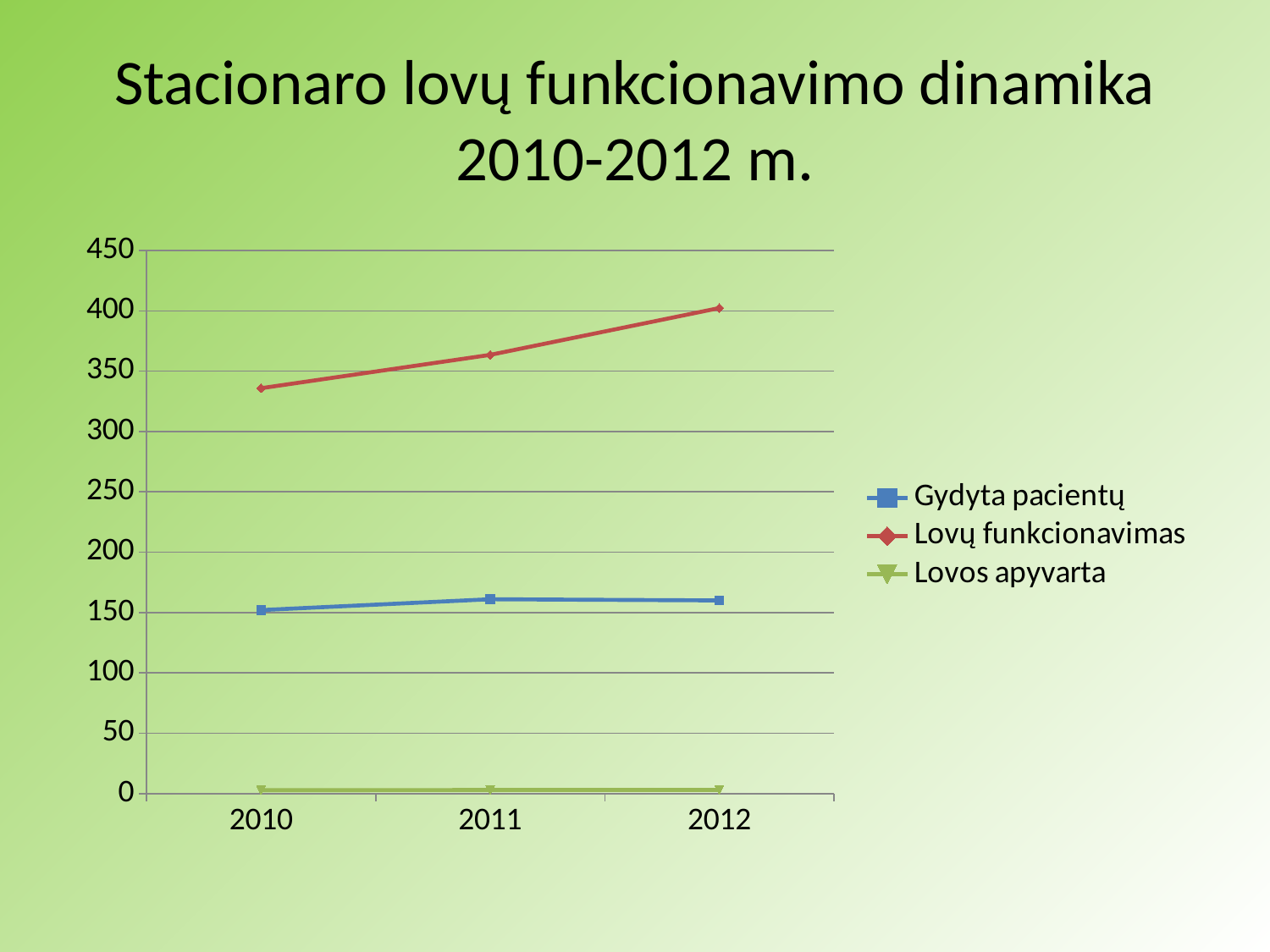
Which series is drawn in red? Lovų funkcionavimas What kind of chart is shown on the slide? line chart Is the Gydyta pacientų value for 2010 greater or less than 200? less Is the Lovos apyvarta value for 2011 greater or less than 50? less Is the Lovų funkcionavimas value for 2010 greater or less than 300? greater In 2012, which series has the larger value, Lovų funkcionavimas or Gydyta pacientų? Lovų funkcionavimas What is the title of the chart slide? Stacionaro lovų funkcionavimo dinamika 2010-2012 m. Does the Lovų funkcionavimas series rise or fall from 2010 to 2012? rise In which year is the Lovų funkcionavimas value lowest? 2010 In which year is the Lovų funkcionavimas value highest? 2012 How many series does the legend list? 3 How many years are shown on the x axis? 3